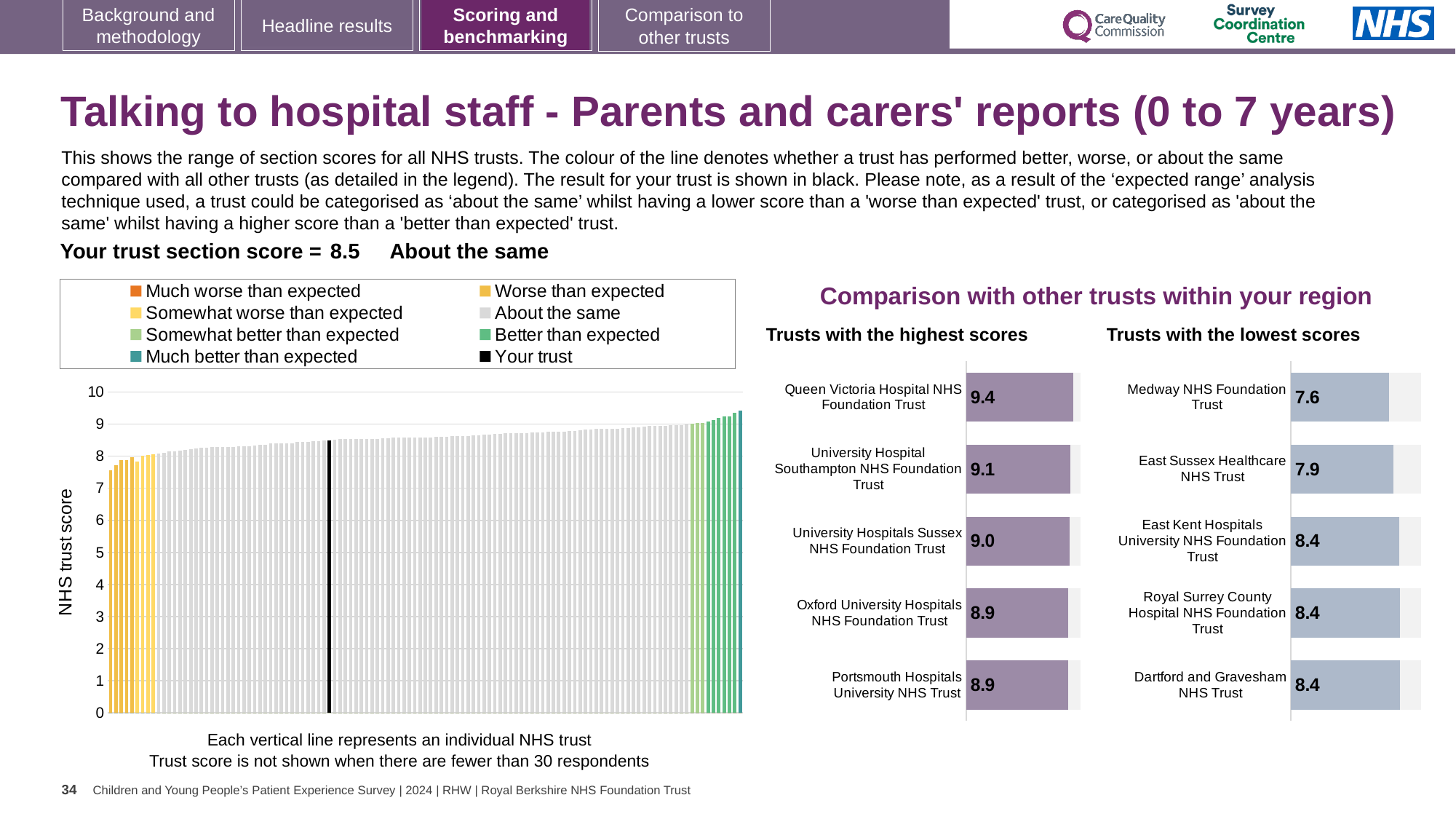
On the 'Trusts with the highest scores' chart, what is the score for University Hospitals Sussex NHS Foundation Trust? 9.0 On the 'Trusts with the highest scores' chart, what is the score for Queen Victoria Hospital NHS Foundation Trust? 9.4 On the main NHS trust score chart on the left, is the value for your trust (the black line) greater or less than 8? greater On the 'Trusts with the lowest scores' chart, which trust has the lowest score? Medway NHS Foundation Trust On the 'Trusts with the lowest scores' chart, what is the score for East Sussex Healthcare NHS Trust? 7.9 On the 'Trusts with the highest scores' chart, what is the difference between the scores of Queen Victoria Hospital NHS Foundation Trust and Portsmouth Hospitals University NHS Trust? 0.5 On the 'Trusts with the lowest scores' chart, what is the difference between the scores of East Sussex Healthcare NHS Trust and Medway NHS Foundation Trust? 0.3 On the 'Trusts with the highest scores' chart, which trust has the highest score? Queen Victoria Hospital NHS Foundation Trust How many entries does the legend of the main NHS trust score chart on the left list? 8 On the 'Trusts with the lowest scores' chart, what is the score for Medway NHS Foundation Trust? 7.6 Which has a higher score: University Hospital Southampton NHS Foundation Trust on the highest scores chart, or East Kent Hospitals University NHS Foundation Trust on the lowest scores chart? University Hospital Southampton NHS Foundation Trust How many trusts are listed on the 'Trusts with the highest scores' chart? 5